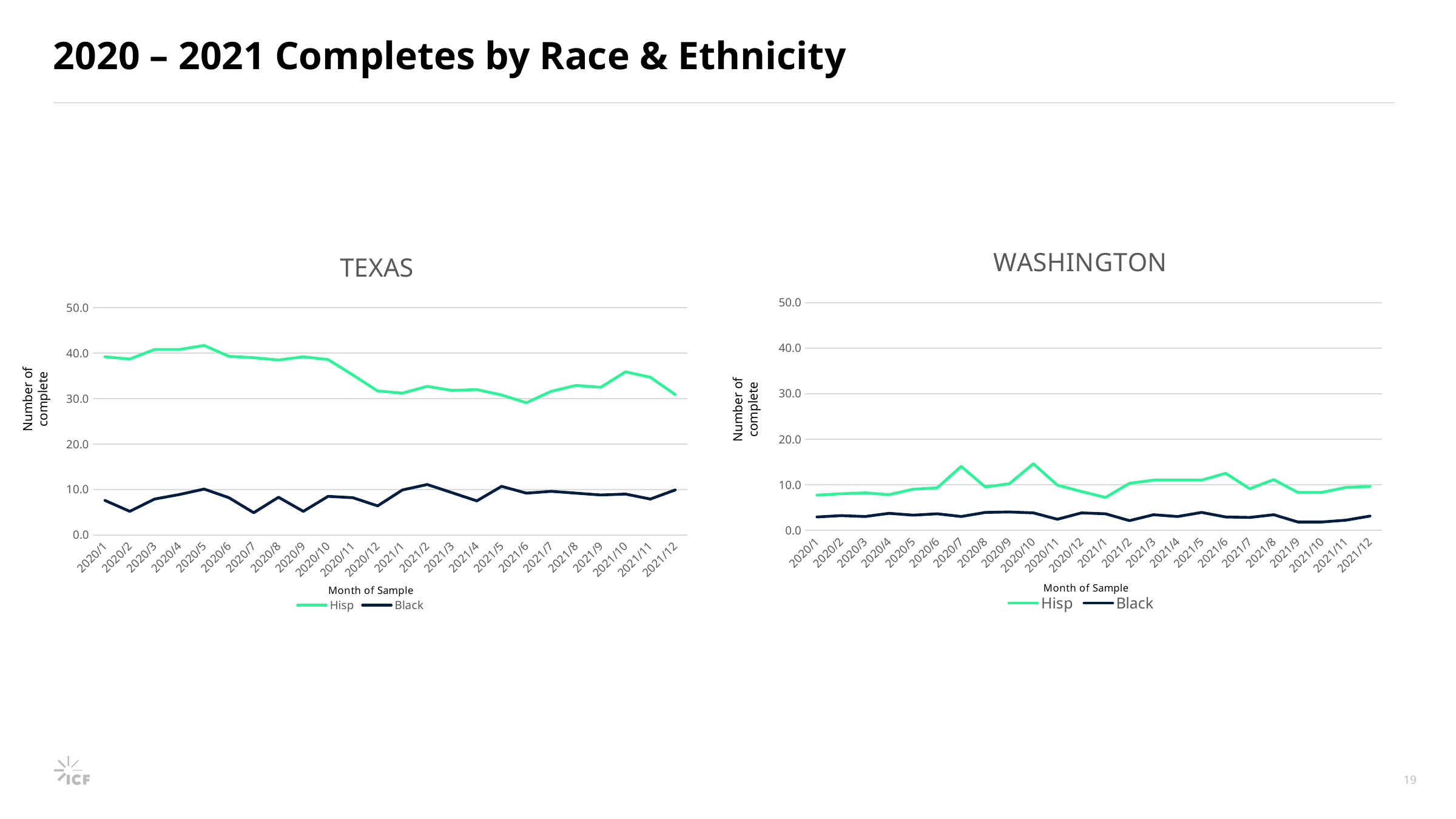
What is the y-axis label on the WASHINGTON chart? Number of complete In the WASHINGTON chart, is the Black value for 2021/12 greater or less than 10.0? less In the TEXAS chart, which series has the larger value at 2020/1, Hisp or Black? Hisp How many series does the legend of the WASHINGTON chart list? 2 What is the x-axis label on the TEXAS chart? Month of Sample In the WASHINGTON chart, which series has the larger value at 2020/7, Hisp or Black? Hisp In the TEXAS chart, is the Hisp value for 2020/5 greater or less than 40.0? greater In the TEXAS chart, does the Hisp series overall rise or fall from 2020/1 to 2021/12? fall In the TEXAS chart, is the Hisp value for 2021/12 greater or less than 40.0? less What kind of chart is the TEXAS chart? line chart How many months are plotted along the x axis of the TEXAS chart? 24